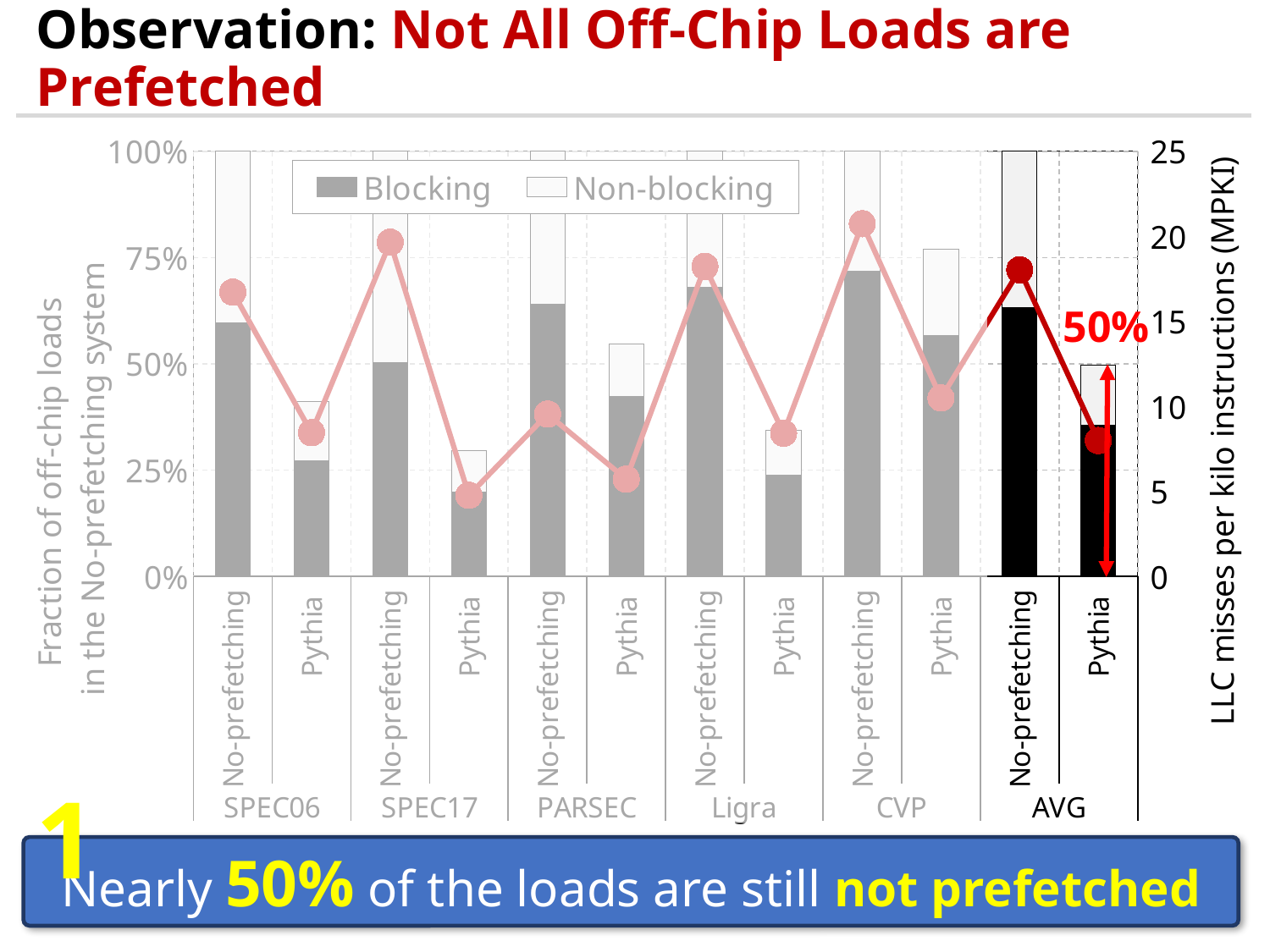
What is the total height of the No-prefetching bar in the AVG group? 100% How many bars are plotted in total? 12 What are the two series named in the legend? Blocking and Non-blocking What is the total height of the Pythia bar in the AVG group, as annotated on the chart? 50% Is the Blocking portion of the No-prefetching bar for SPEC06 greater or less than 50%? greater How many benchmark groups are shown along the x axis? 6 What is the label of the right-hand y axis? LLC misses per kilo instructions (MPKI) Is the MPKI line value for No-prefetching in SPEC17 greater or less than 15? greater What kind of chart is shown on the slide? Stacked bar chart with a line overlay Among the Pythia bars, which benchmark group has the tallest stacked bar? CVP Is the Blocking portion of the Pythia bar for SPEC17 greater or less than 25%? less How many series does the legend list? 2